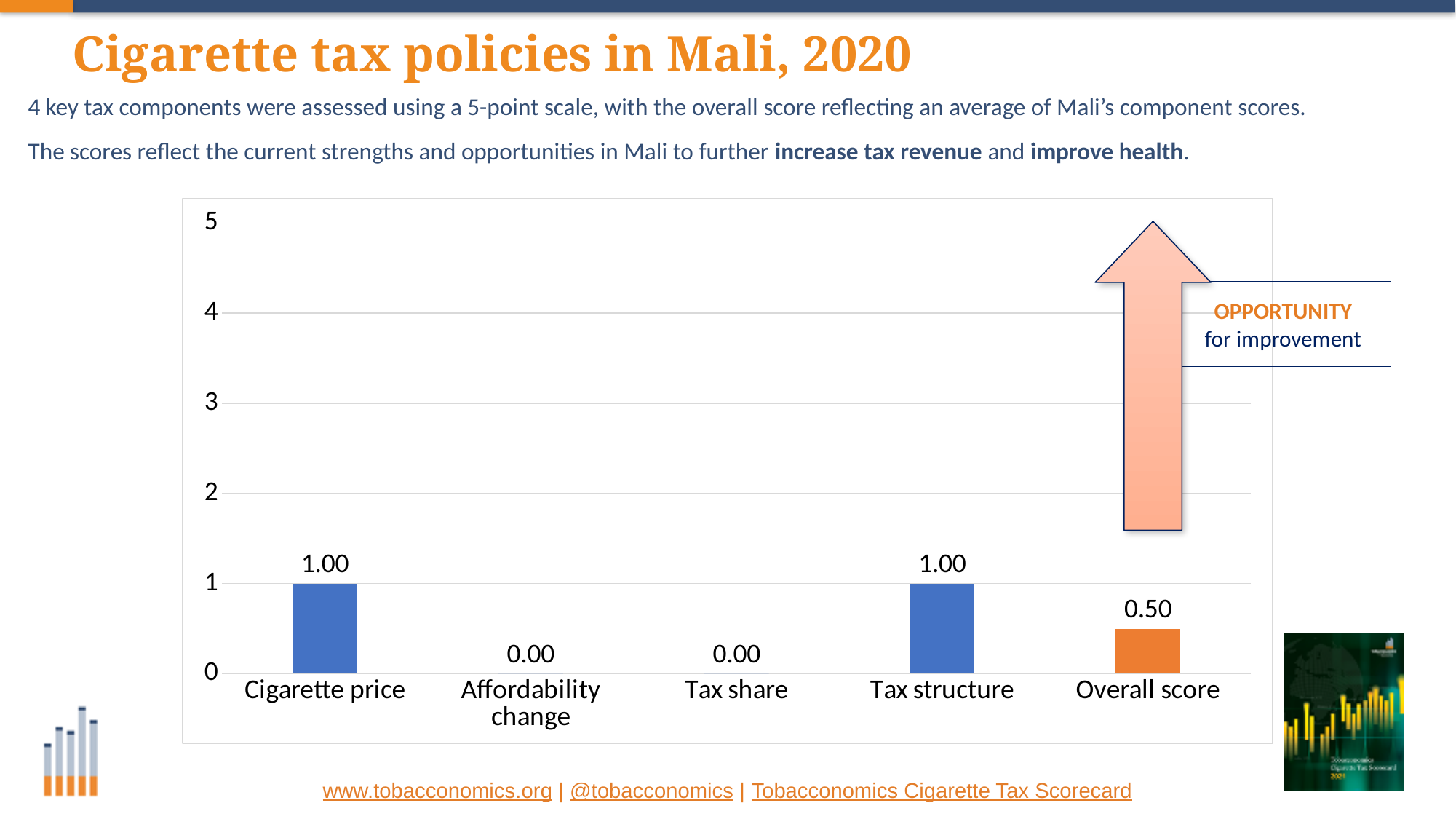
Which is larger, the value for Tax structure or the value for Overall score? Tax structure What is the value for Cigarette price? 1.00 What is the value for Affordability change? 0.00 Is the value for Cigarette price greater or less than 2? less What kind of chart is shown on the slide? bar chart What is the difference between the Cigarette price score and the Overall score? 0.50 What is the Overall score? 0.50 What is the value for Tax structure? 1.00 How many categories are shown on the x axis? 5 What is the value for Tax share? 0.00 What colour is the Overall score bar? orange What is the highest value shown on the y axis? 5